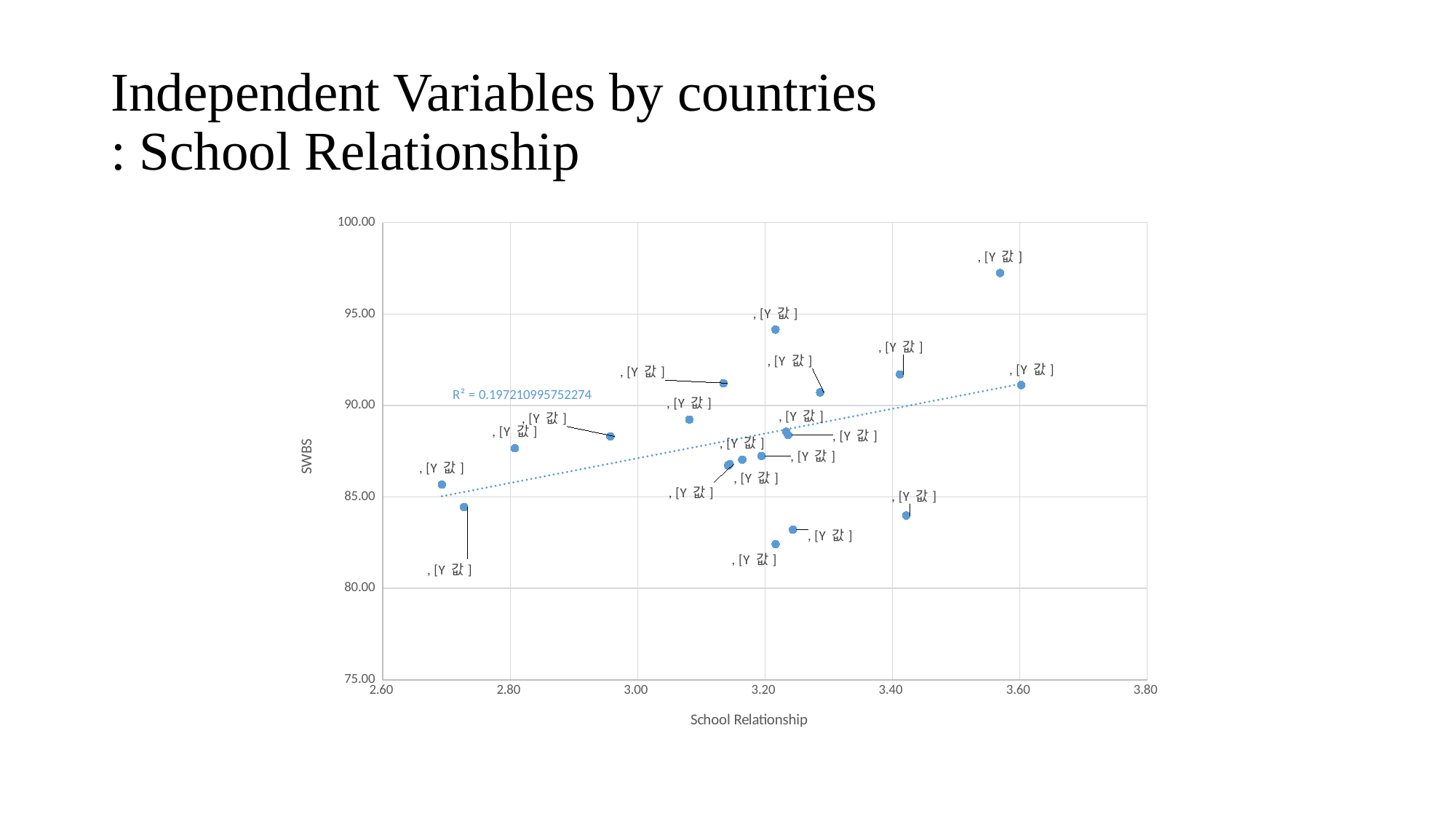
What is the minimum value shown on the x axis? 2.60 What is the title of the x axis of the chart? School Relationship Is the SWBS value of the lowest point on the chart greater or less than 85.00? less Is the School Relationship value of the highest SWBS point greater or less than 3.40? greater What is the title of the y axis of the chart? SWBS Does the dotted trendline rise or fall as School Relationship increases? rises Is the School Relationship value of the leftmost point greater or less than 2.80? less What is the R² value printed on the chart? R² = 0.197210995752274 What kind of chart is shown on the slide? scatter chart What is the maximum value shown on the y axis? 100.00